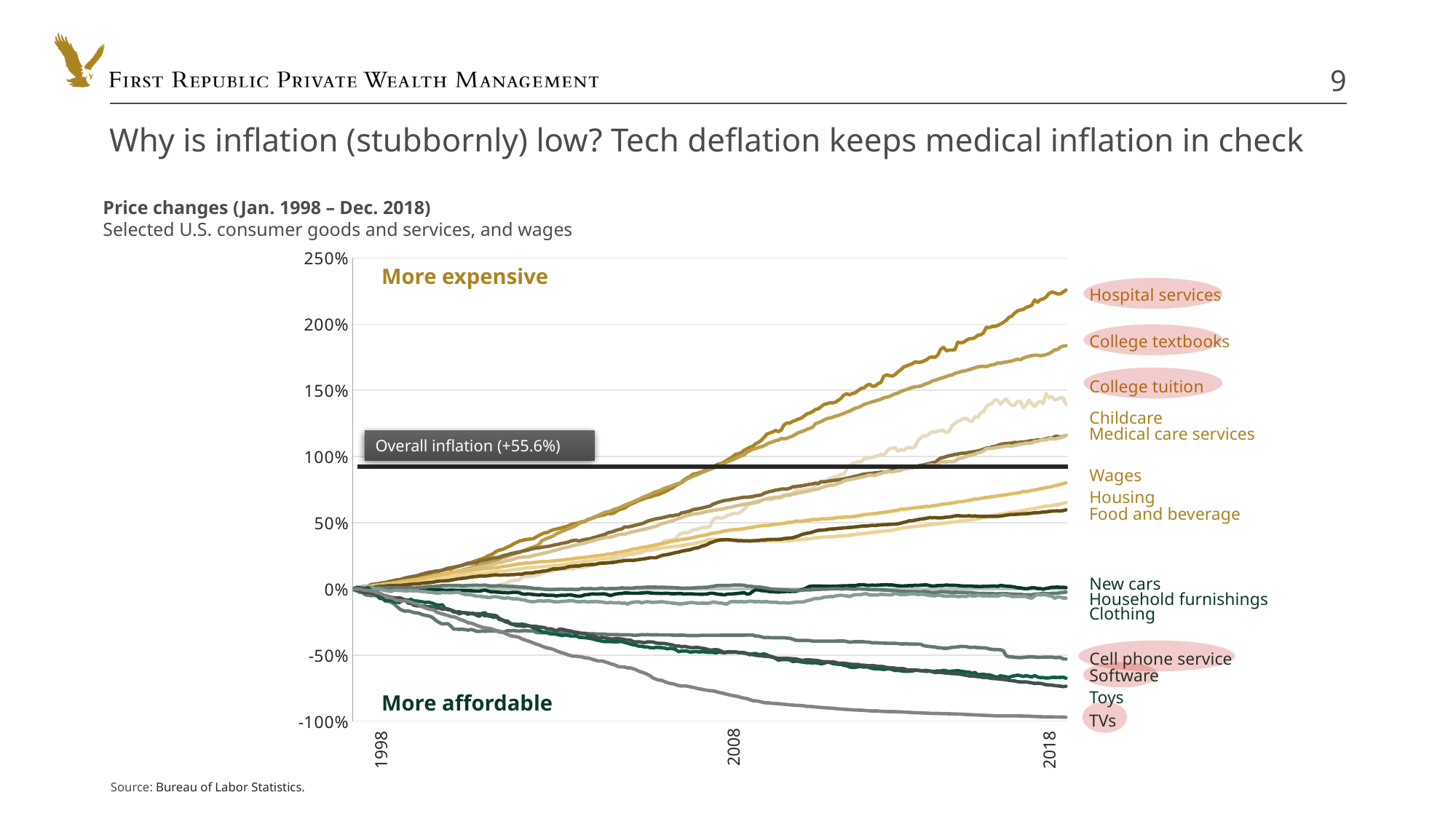
Does the TVs line rise or fall from 1998 to 2018? Fall Which is larger in 2018, the value for Hospital services or the value for College tuition? Hospital services Is the 2018 value for Hospital services greater or less than 200%? greater Which series has the lowest value at the end of the period (2018)? TVs Is the 2018 value for Toys greater or less than -50%? less What overall inflation figure is printed on the chart? +55.6% What source is cited for the chart data? Bureau of Labor Statistics Is the 2018 value for College textbooks greater or less than 150%? greater What kind of chart is shown on the slide? Line chart What is the title of the chart? Price changes (Jan. 1998 – Dec. 2018) How many labeled series are plotted on the chart? 15 Which series has the highest value at the end of the period (2018)? Hospital services